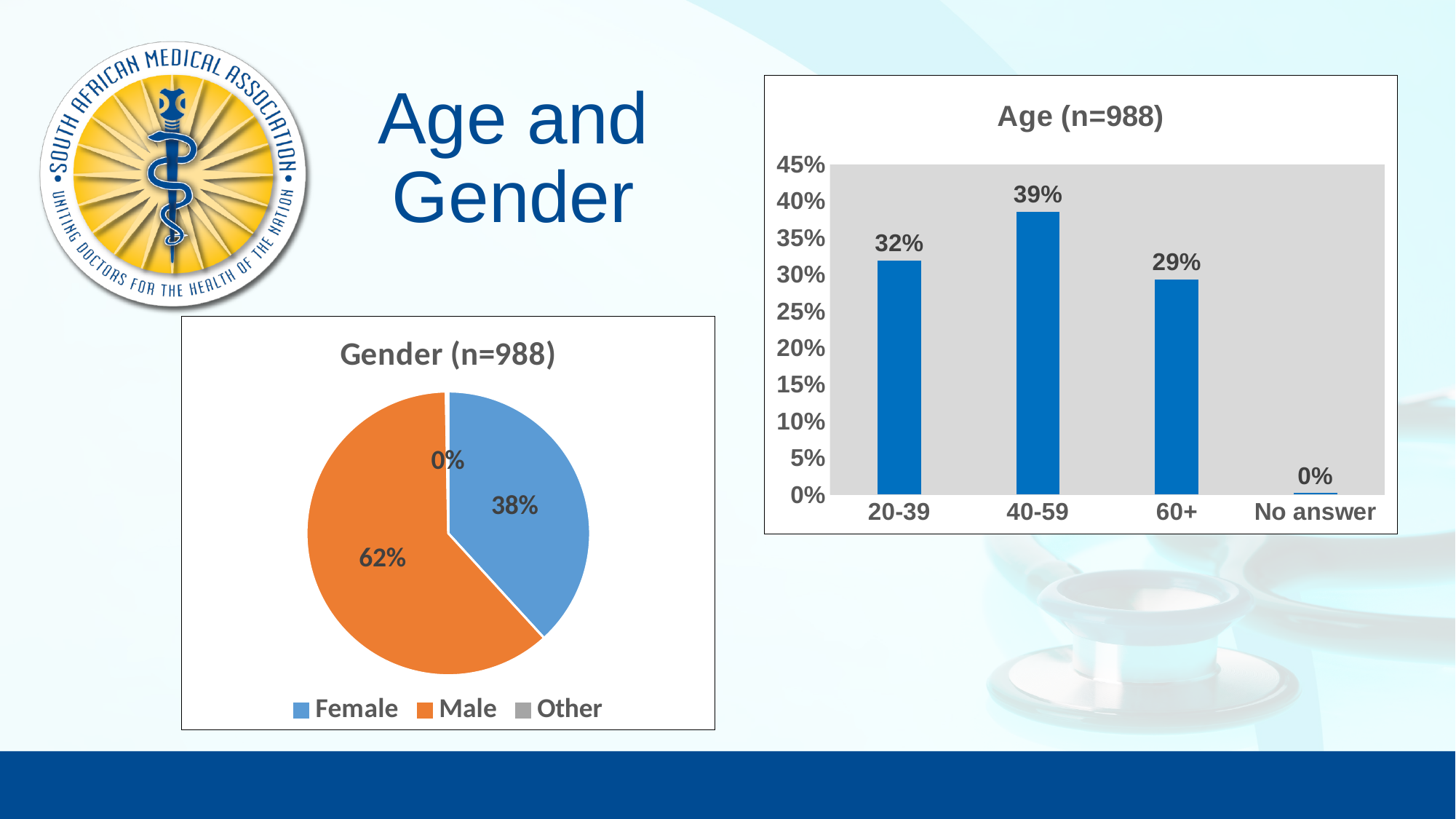
In the 'Age (n=988)' chart, which age category has the highest value? 40-59 In the 'Gender (n=988)' chart, what share of the pie is Male? 62% In the 'Age (n=988)' chart, what is the difference between the values for 40-59 and 60+? 10% In the 'Age (n=988)' chart, how many age categories are shown on the x axis? 4 In the 'Gender (n=988)' chart, what is the value for Female? 38% In the 'Age (n=988)' chart, what is the value for the 40-59 age group? 39% In the 'Gender (n=988)' chart, what colour is the Male slice? Orange What kind of chart is the 'Age (n=988)' chart? Bar chart In the 'Age (n=988)' chart, which category has the lowest value? No answer In the 'Age (n=988)' chart, which is larger, the value for 20-39 or the value for 60+? 20-39 In the 'Age (n=988)' chart, what is the value for the 20-39 age group? 32% In the 'Gender (n=988)' chart, how many entries does the legend list? 3